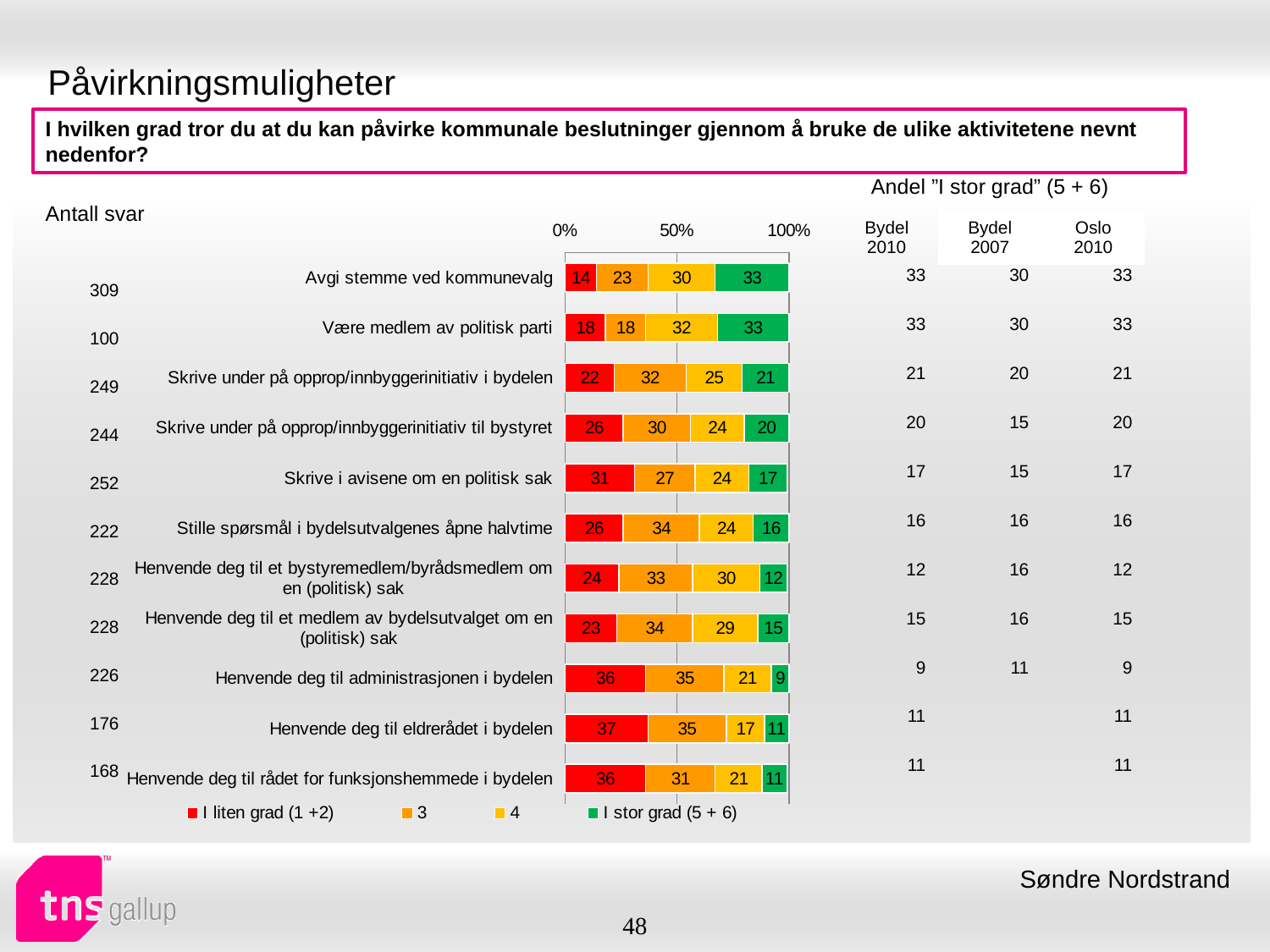
What colour represents 'I stor grad (5 + 6)' in the chart? green What is the value of series '4' for 'Være medlem av politisk parti'? 32 What kind of chart is shown on the slide? bar chart What is the difference between the 'I stor grad (5 + 6)' values for 'Avgi stemme ved kommunevalg' and 'Skrive i avisene om en politisk sak'? 16 What is the total of the stacked bar for 'Avgi stemme ved kommunevalg'? 100 What is the value of 'I stor grad (5 + 6)' for 'Avgi stemme ved kommunevalg'? 33 How many series does the chart legend list? 4 What is the value of 'I liten grad (1 +2)' for 'Henvende deg til eldrerådet i bydelen'? 37 How many categories (activities) are plotted in the chart? 11 Which category has the lowest value for 'I stor grad (5 + 6)'? Henvende deg til administrasjonen i bydelen What is the value of series '3' for 'Stille spørsmål i bydelsutvalgenes åpne halvtime'? 34 Which is larger: the 'I liten grad (1 +2)' value for 'Skrive i avisene om en politisk sak' or for 'Skrive under på opprop/innbyggerinitiativ i bydelen'? Skrive i avisene om en politisk sak